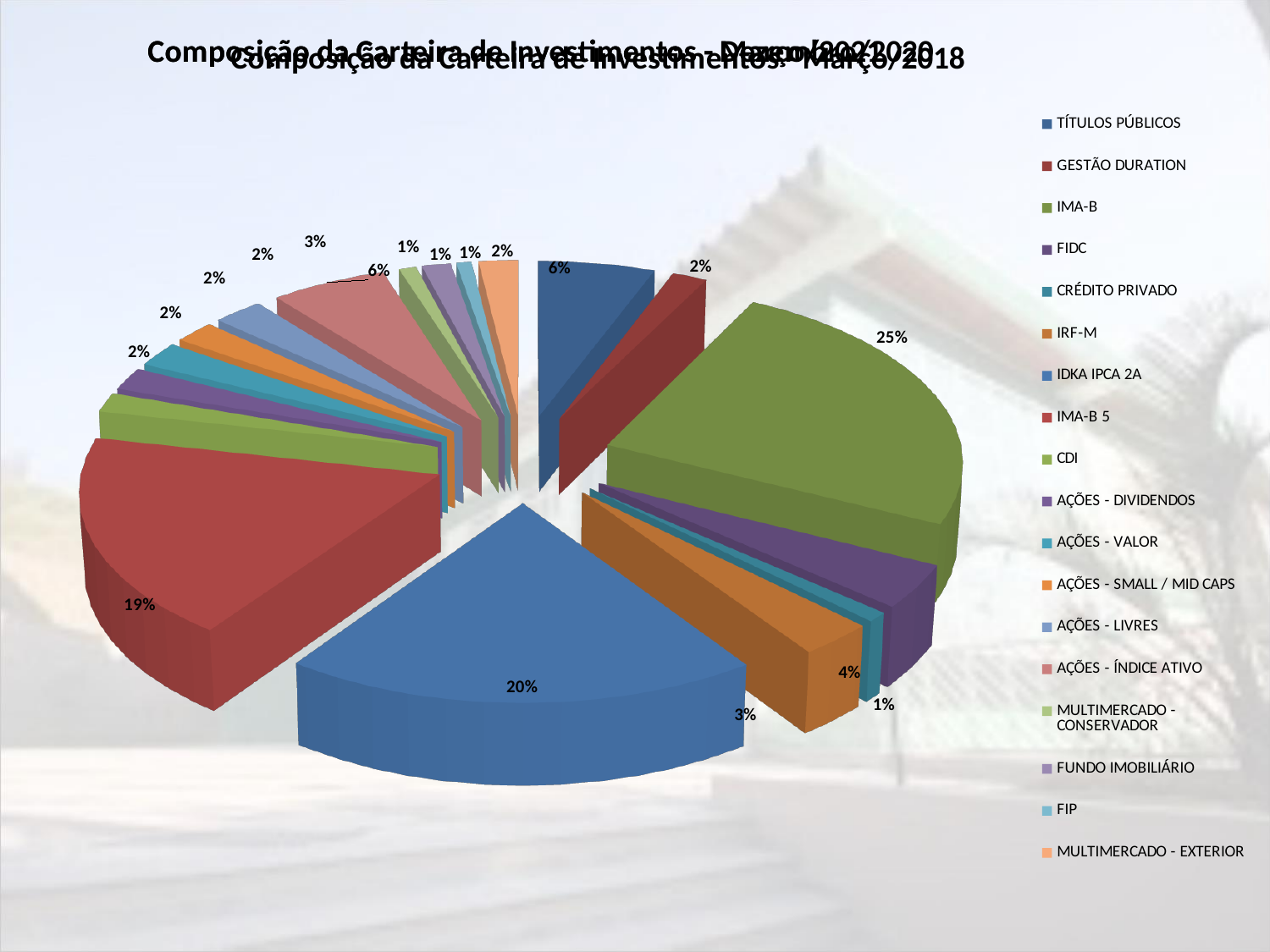
Which category has the largest share of the pie? IMA-B What percentage is shown for AÇÕES - ÍNDICE ATIVO? 6% What kind of chart is shown on the slide? pie chart What percentage is shown for TÍTULOS PÚBLICOS? 6% What share of the portfolio is IMA-B? 25% What is the difference between the shares of IMA-B and IDKA IPCA 2A? 5% What is the combined share of IMA-B, IDKA IPCA 2A and IMA-B 5? 64% Which is larger, the share of IDKA IPCA 2A or the share of IMA-B 5? IDKA IPCA 2A How many entries does the legend list? 18 What percentage is shown for IDKA IPCA 2A? 20% What percentage is shown for FIDC? 4% What percentage is shown for IMA-B 5? 19%